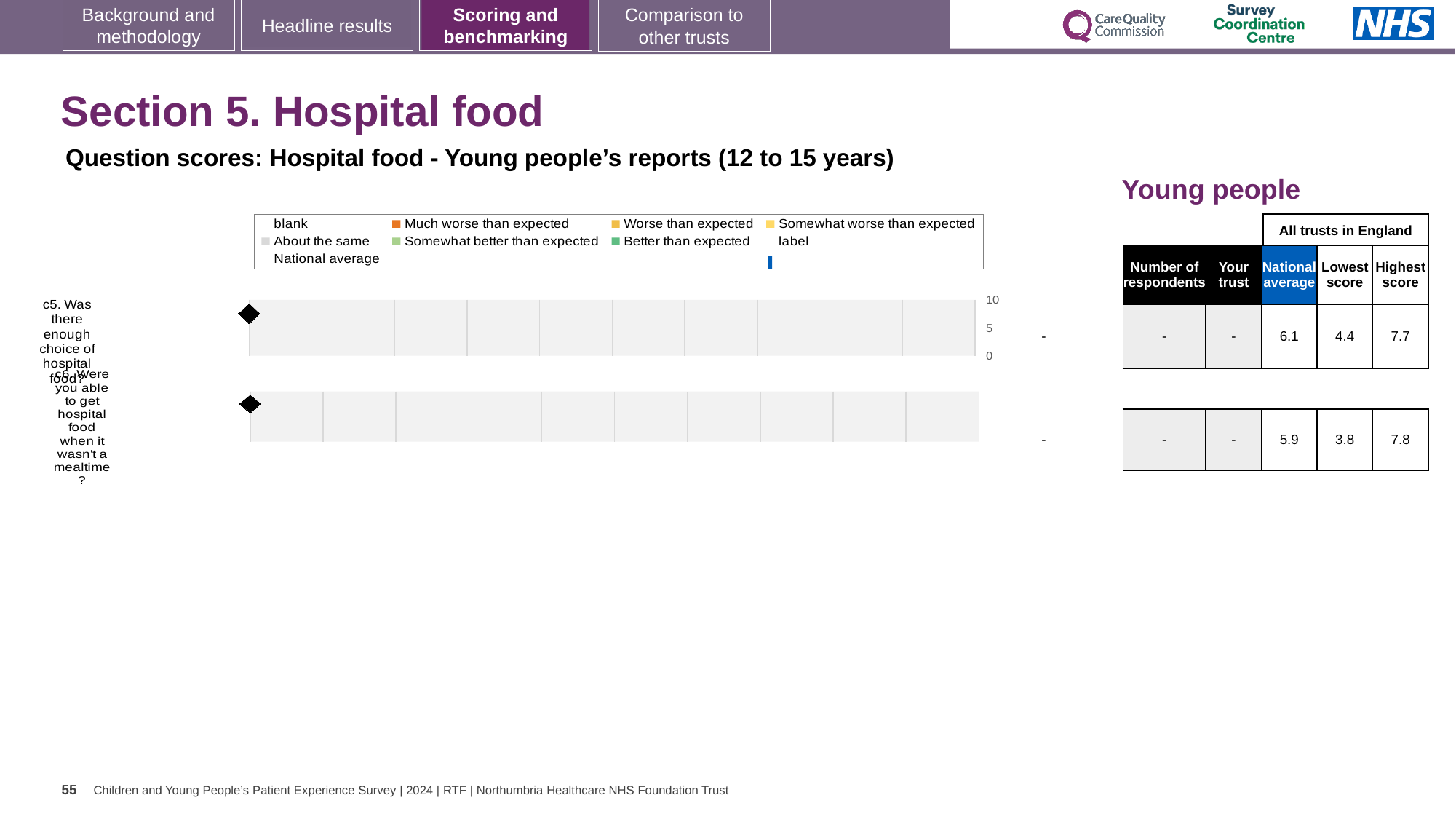
What is the difference between the highest score and the lowest score for c5 in the table? 3.3 How many questions (categories) are plotted on the chart? 2 What is the maximum value shown on the chart's score axis? 10 In the table next to the chart, what is the lowest score for c6? 3.8 In the table next to the chart, what is the highest score for c6 'Were you able to get hospital food when it wasn't a mealtime?'? 7.8 Which question has the higher national average in the table, c5 or c6? c5 In the table next to the chart, what is the 'Your trust' score shown for c5? - What kind of chart is shown on the slide? bar chart What colour does the legend use for 'Much worse than expected'? orange What is the difference between the national averages of c5 and c6 in the table? 0.2 In the table next to the chart, what is the national average score for c5 'Was there enough choice of hospital food?'? 6.1